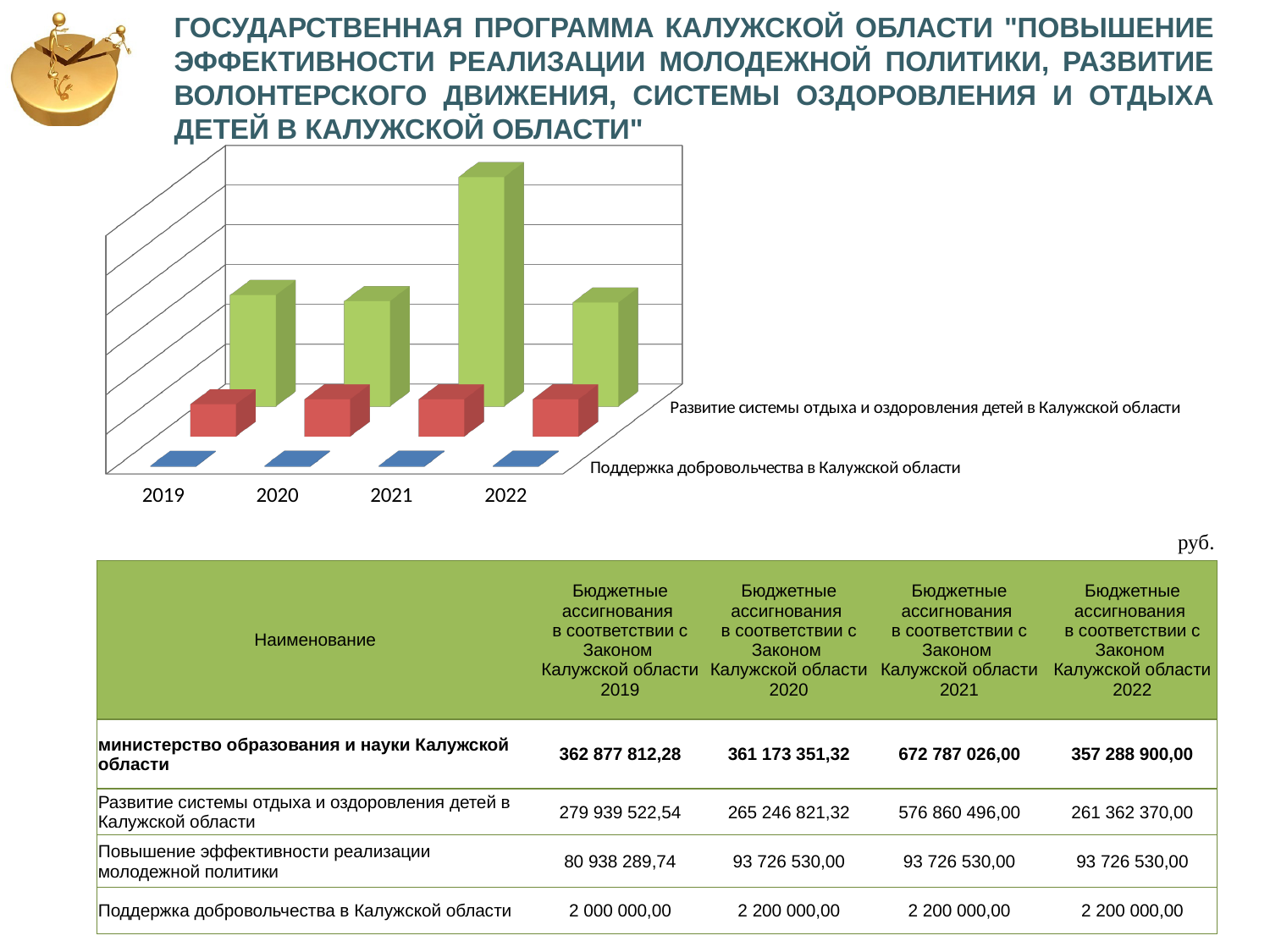
What is the first year shown on the x axis of the chart? 2019 How many data series are plotted in the chart? 3 In which year is the bar for 'Развитие системы отдыха и оздоровления детей в Калужской области' the tallest? 2021 For 'Развитие системы отдыха и оздоровления детей в Калужской области', which year has the larger bar: 2021 or 2022? 2021 How many years are shown along the x axis of the chart? 4 Which series has the smallest bars in the chart? Поддержка добровольчества в Калужской области Does the bar for 'Развитие системы отдыха и оздоровления детей в Калужской области' rise or fall from 2021 to 2022? fall What colour are the bars for 'Поддержка добровольчества в Калужской области'? blue What kind of chart is shown on the slide? bar chart In 2021, is the red bar taller or shorter than the green bar? shorter For 'Развитие системы отдыха и оздоровления детей в Калужской области', which year has the larger bar: 2019 or 2021? 2021 Which series has the tallest bars in the chart? Развитие системы отдыха и оздоровления детей в Калужской области